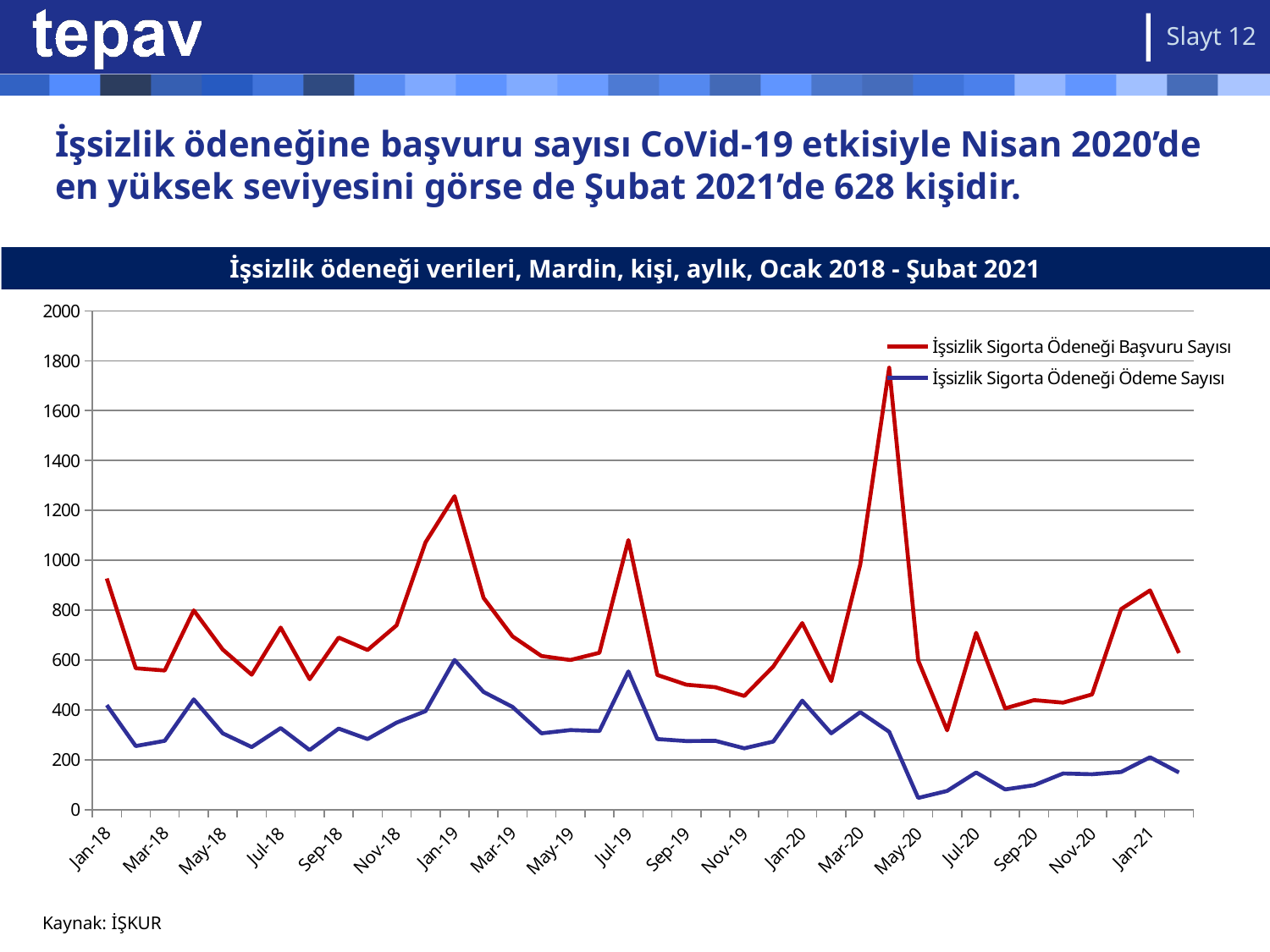
Is the value for İşsizlik Sigorta Ödeneği Başvuru Sayısı in April 2020 greater or less than 1600? greater Is the value for İşsizlik Sigorta Ödeneği Ödeme Sayısı in May 2020 greater or less than 200? less Which is larger in January 2019: İşsizlik Sigorta Ödeneği Başvuru Sayısı or İşsizlik Sigorta Ödeneği Ödeme Sayısı? İşsizlik Sigorta Ödeneği Başvuru Sayısı What is the value of İşsizlik Sigorta Ödeneği Başvuru Sayısı in February 2021 (Şubat 2021)? 628 What kind of chart is shown on the slide? line chart Which series is drawn in red? İşsizlik Sigorta Ödeneği Başvuru Sayısı In which month does İşsizlik Sigorta Ödeneği Başvuru Sayısı reach its highest value? April 2020 (Nisan 2020) Is the value for İşsizlik Sigorta Ödeneği Başvuru Sayısı in January 2018 greater or less than 800? greater What is the title of the chart? İşsizlik ödeneği verileri, Mardin, kişi, aylık, Ocak 2018 - Şubat 2021 How many series does the legend list? 2 Does İşsizlik Sigorta Ödeneği Ödeme Sayısı rise or fall from March 2020 to May 2020? fall